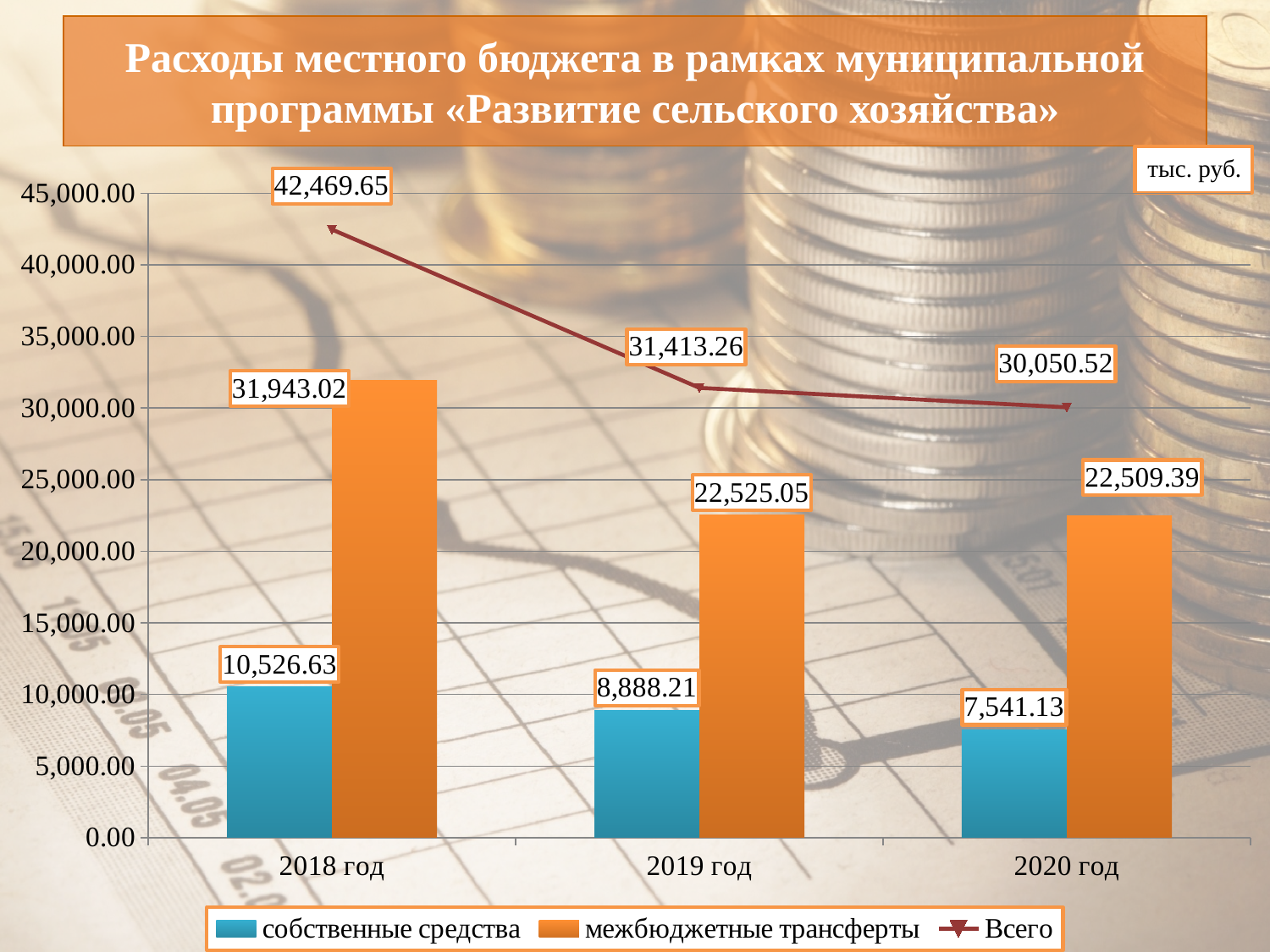
What is the difference between межбюджетные трансферты and собственные средства in 2018 год? 21,416.39 What is the value of собственные средства for 2018 год? 10,526.63 How many series does the legend list? 3 What is the value of Всего for 2020 год? 30,050.52 In which year is собственные средства the lowest? 2020 год Is the value of межбюджетные трансферты for 2020 год greater or less than 25,000.00? less What is the value of межбюджетные трансферты for 2019 год? 22,525.05 By how much did Всего decrease from 2018 год to 2020 год? 12,419.13 Which is larger in 2020 год: собственные средства or межбюджетные трансферты? межбюджетные трансферты In which year is Всего the highest? 2018 год How many years are shown on the x axis? 3 What is the trend of Всего from 2018 год to 2020 год? falling